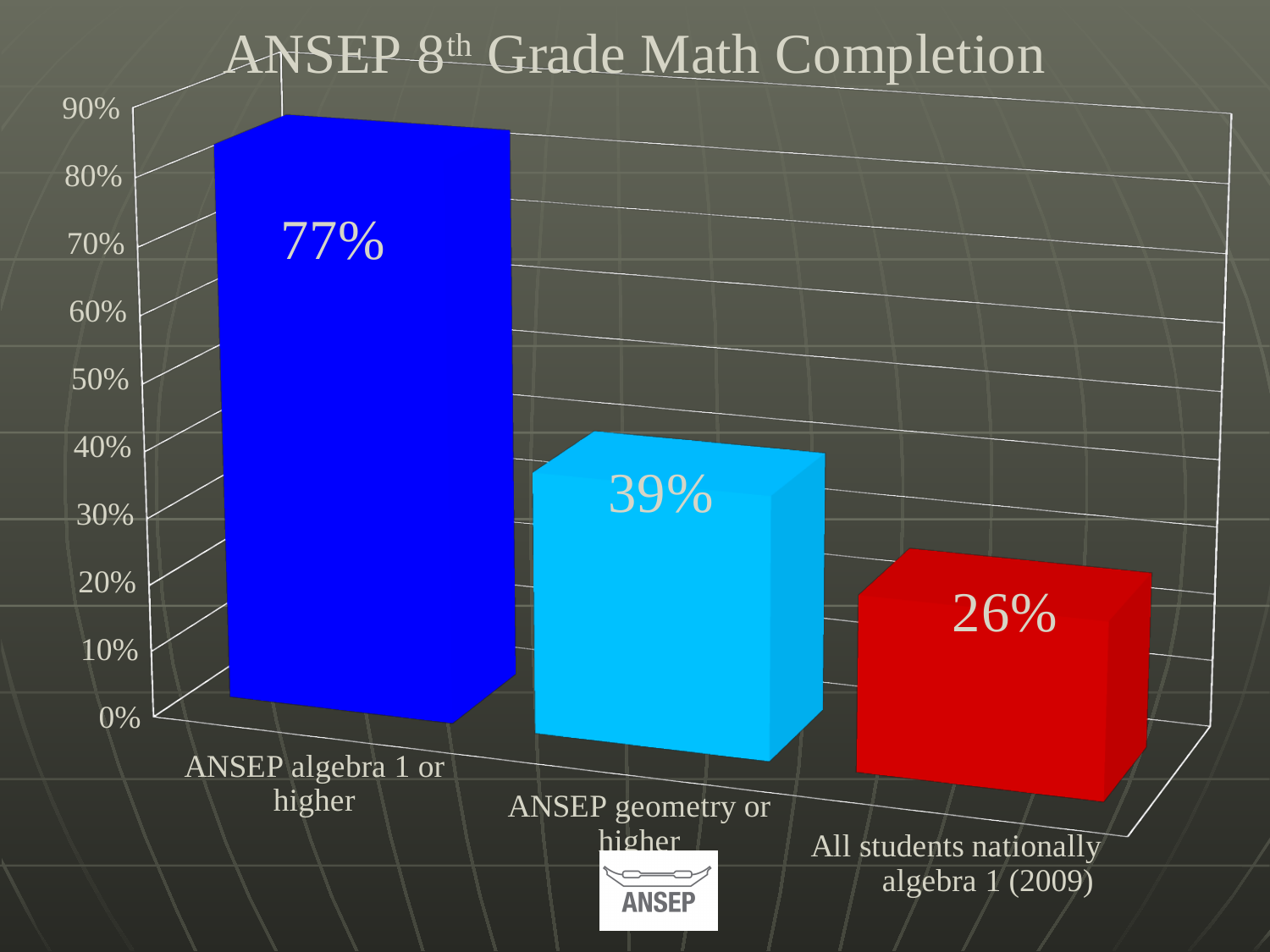
What is the difference between ANSEP algebra 1 or higher and All students nationally algebra 1 (2009)? 51% What is the value for All students nationally algebra 1 (2009)? 26% What is the title of the chart? ANSEP 8th Grade Math Completion Which category has the highest value? ANSEP algebra 1 or higher What is the value for ANSEP algebra 1 or higher? 77% What is the value for ANSEP geometry or higher? 39% What kind of chart is shown on the slide? bar chart Which category has the lowest value? All students nationally algebra 1 (2009) Which is larger, ANSEP geometry or higher or All students nationally algebra 1 (2009)? ANSEP geometry or higher What is the difference between ANSEP geometry or higher and All students nationally algebra 1 (2009)? 13% How many categories are shown in the chart? 3 Is the value for ANSEP geometry or higher greater or less than 50%? less